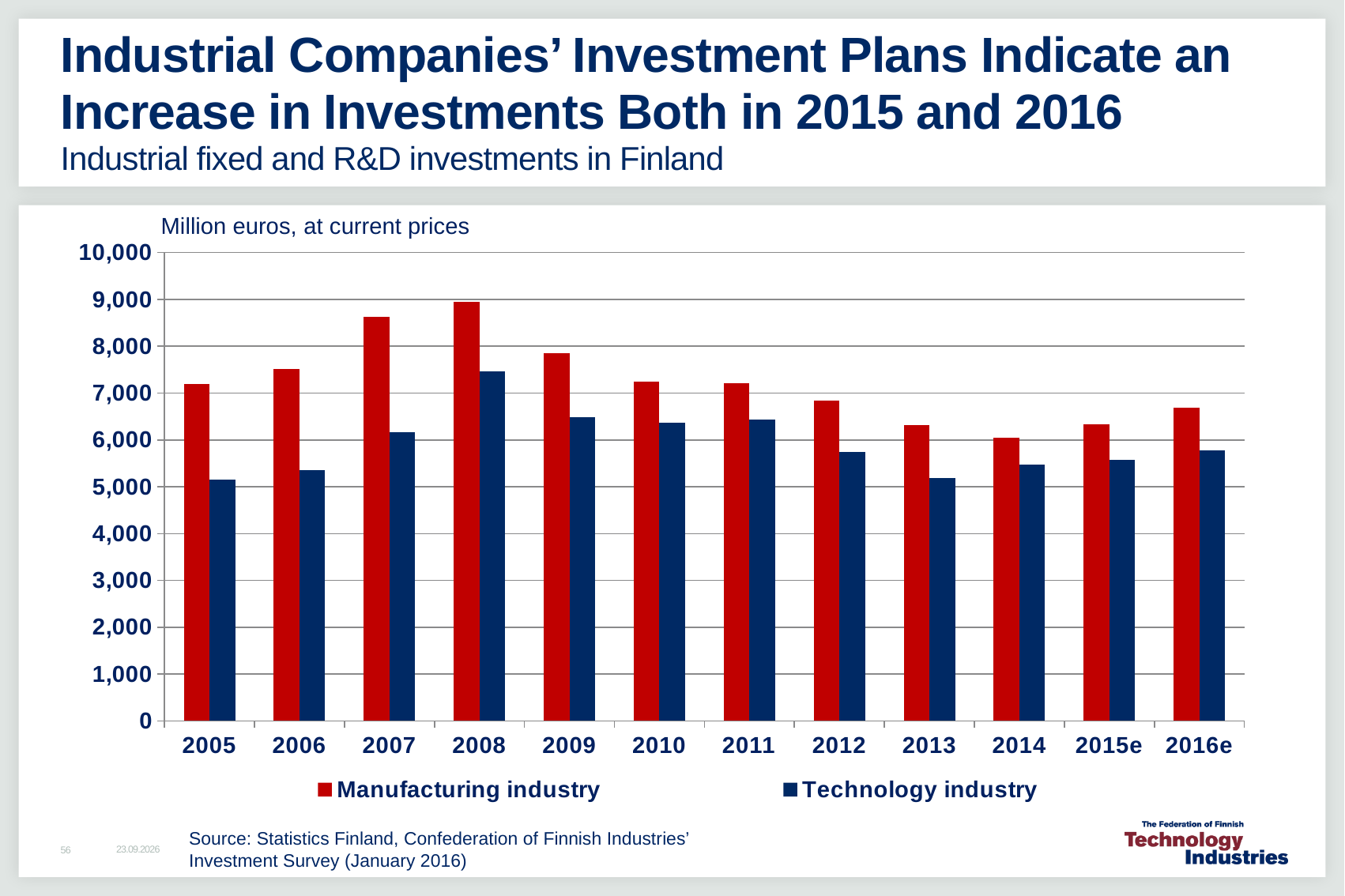
In which year is the Technology industry value highest? 2008 In which year is the Manufacturing industry value highest? 2008 Which is larger, the Manufacturing industry value for 2007 or for 2009? 2007 Do the Manufacturing industry values rise or fall from 2008 to 2014? Fall Is the Technology industry value for 2008 greater or less than 7,000? greater What kind of chart is shown on the slide? Bar chart What unit is stated above the y axis? Million euros, at current prices In which year is the Manufacturing industry value lowest? 2014 How many years are shown on the x axis? 12 Is the Technology industry value for 2005 greater or less than 6,000? less Is the Manufacturing industry value for 2008 greater or less than 8,000? greater How many series does the legend list? 2